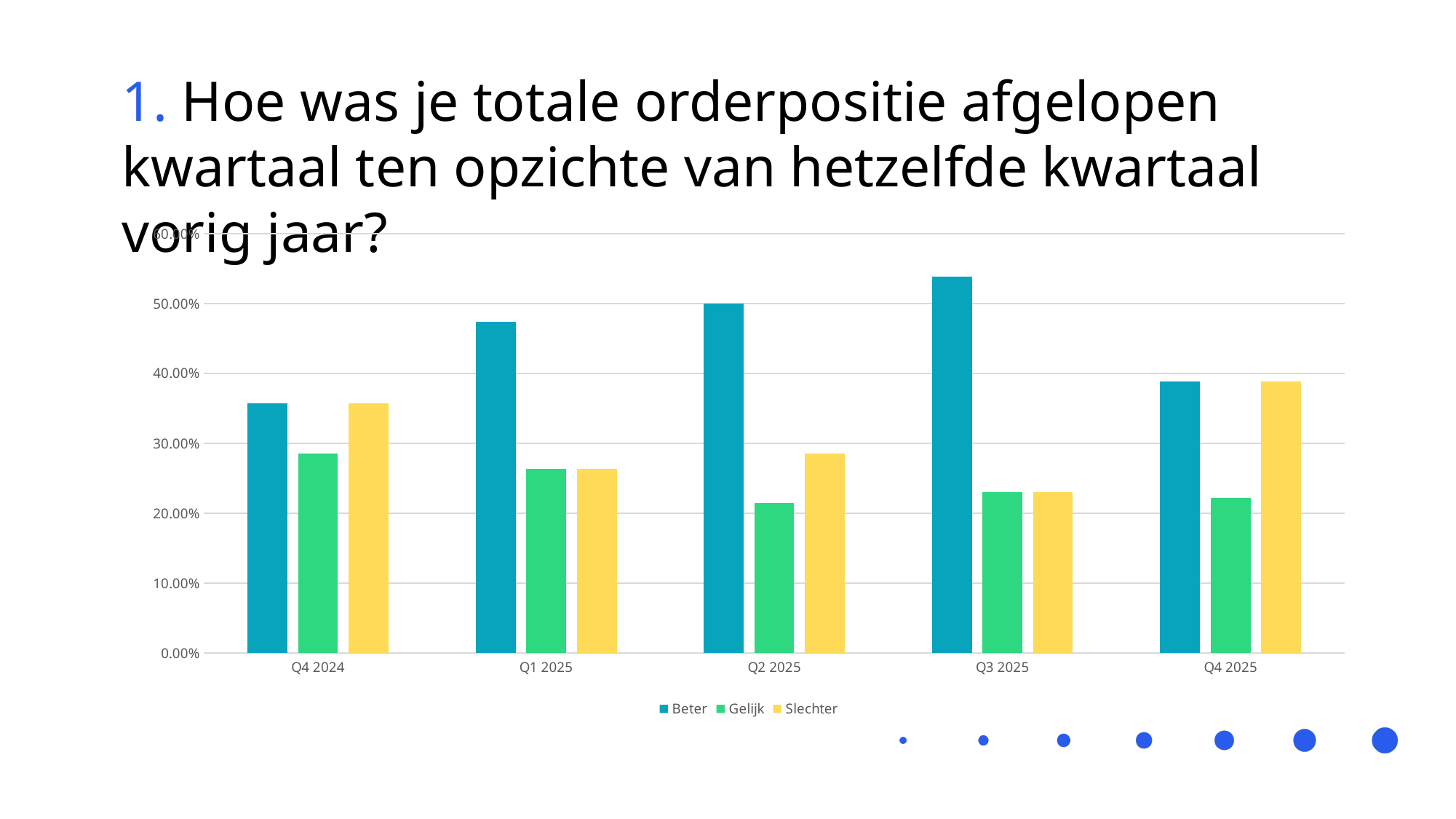
In which quarter is the value for Beter the lowest? Q4 2024 How many quarters are shown on the x axis? 5 Is the value for Beter in Q3 2025 greater or less than 50.00%? greater From Q4 2024 to Q3 2025, does the value for Beter rise or fall? rise Which series are listed in the legend? Beter, Gelijk, Slechter Is the value for Beter in Q1 2025 greater or less than 50.00%? less In Q4 2025, which is larger: Gelijk or Slechter? Slechter How many series does the legend list? 3 In which quarter is the value for Beter the highest? Q3 2025 Is the value for Gelijk in Q4 2024 greater or less than 30.00%? less In which quarter is the value for Slechter the highest? Q4 2025 What kind of chart is shown on the slide? bar chart